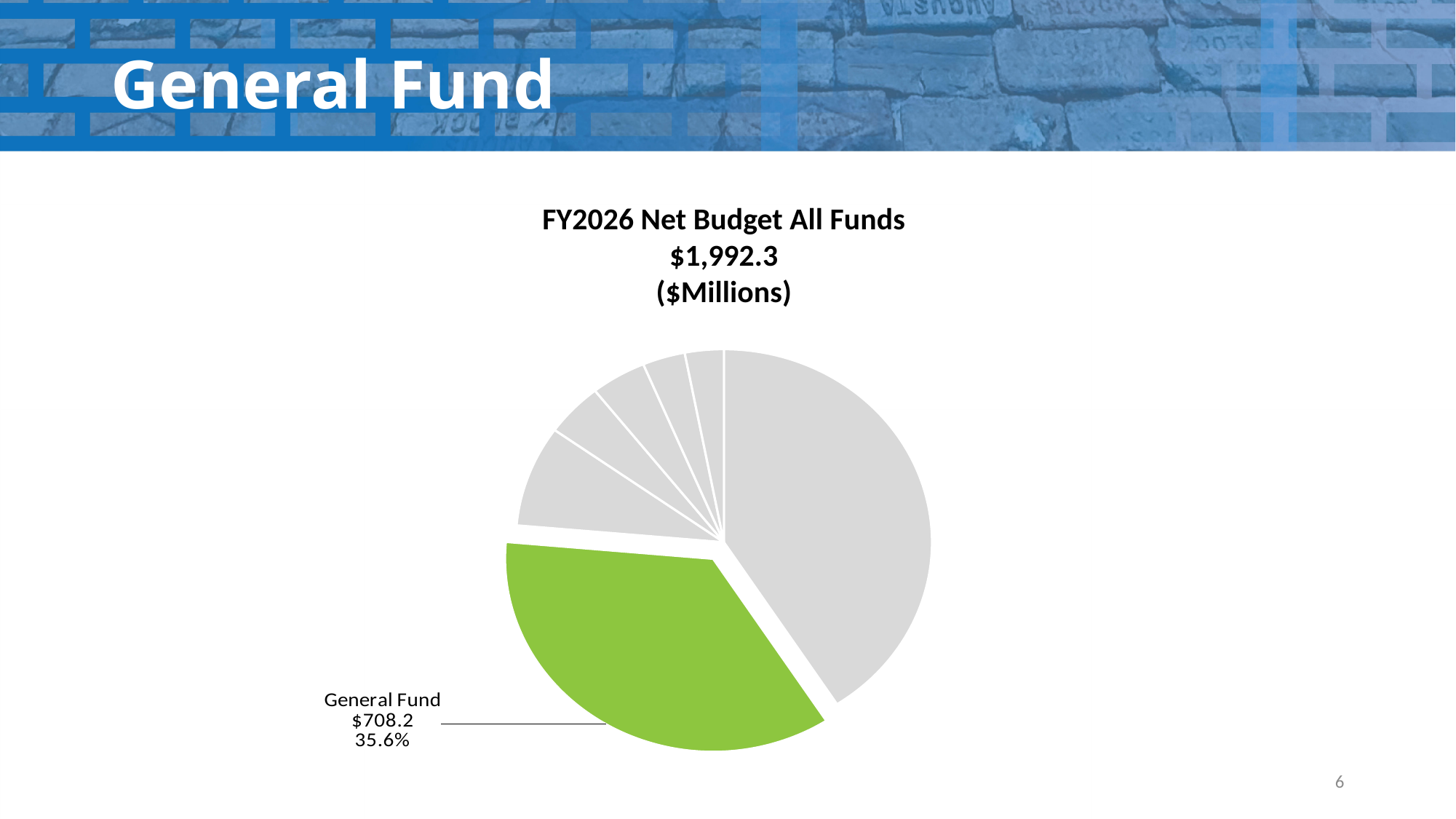
What type of chart is shown on the slide? Pie chart What total amount is shown in the chart title for the FY2026 Net Budget All Funds? $1,992.3 What is the title of the pie chart? FY2026 Net Budget All Funds $1,992.3 ($Millions) Is the General Fund share of the pie greater or less than 50%? less Which slice of the pie chart is highlighted in green? General Fund How many slices in the pie chart have a data label? 1 What is the value of the General Fund slice in the pie chart? $708.2 In what units are the values in the pie chart expressed? $Millions What share of the pie does the General Fund slice represent? 35.6%